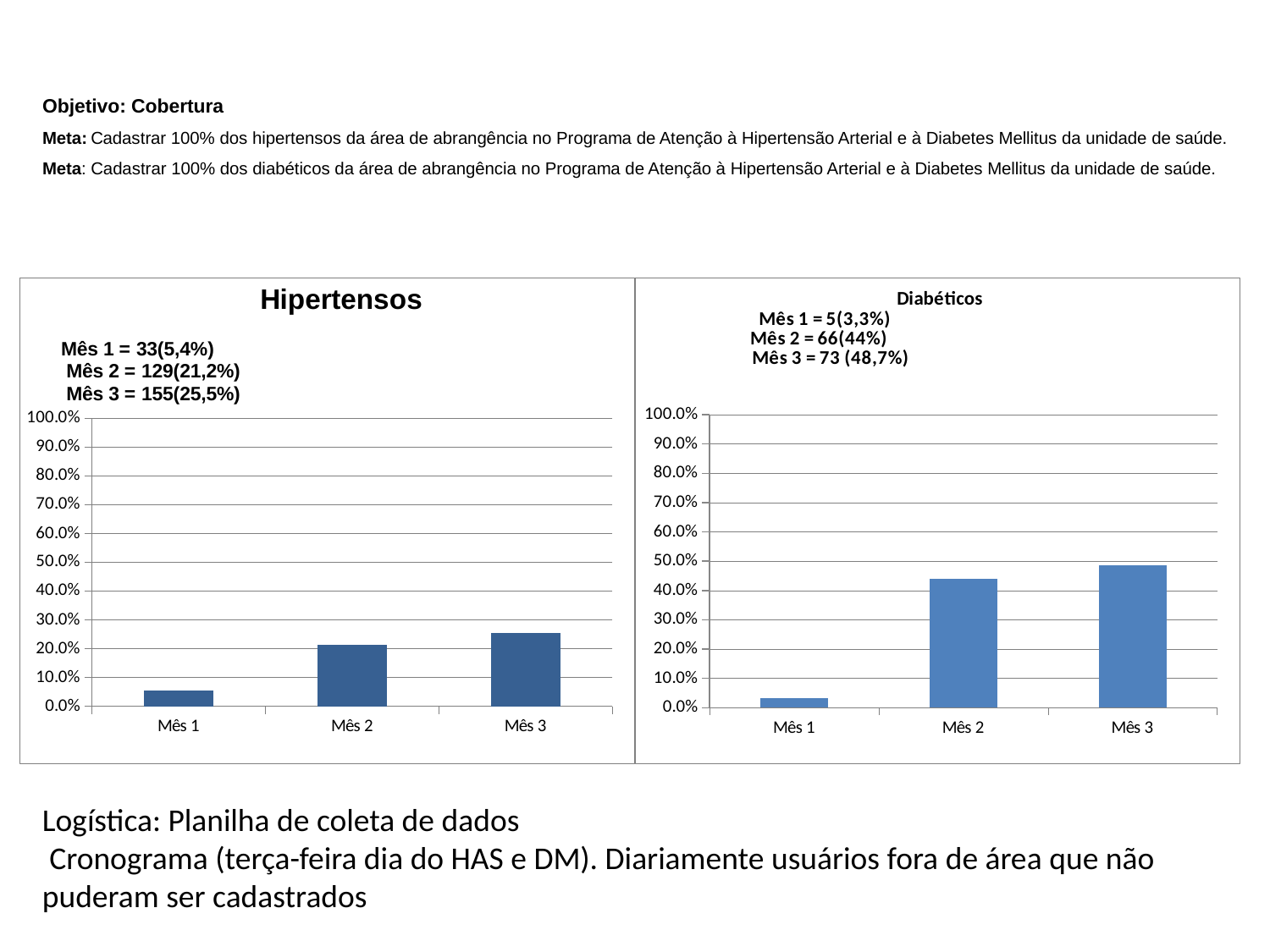
In the Diabéticos chart, how many diabetic patients were registered in Mês 1? 5 In the Hipertensos chart, which month has the lowest value? Mês 1 How many months (categories) are plotted in the Diabéticos chart? 3 What type of chart is the Hipertensos chart? bar chart In the Hipertensos chart, how many hypertensive patients were registered in Mês 3? 155 In the Diabéticos chart, which month has the highest value? Mês 3 In the Diabéticos chart, what percentage is shown for Mês 3? 48,7% Which is larger: the Mês 2 percentage in the Hipertensos chart or the Mês 2 percentage in the Diabéticos chart? Diabéticos In the Hipertensos chart, is the value for Mês 3 greater or less than 30.0%? less In the Diabéticos chart, do the values rise or fall from Mês 1 to Mês 3? rise In the Diabéticos chart, what is the difference in percentage points between Mês 3 and Mês 2? 4,7 In the Hipertensos chart, what percentage is shown for Mês 2? 21,2%